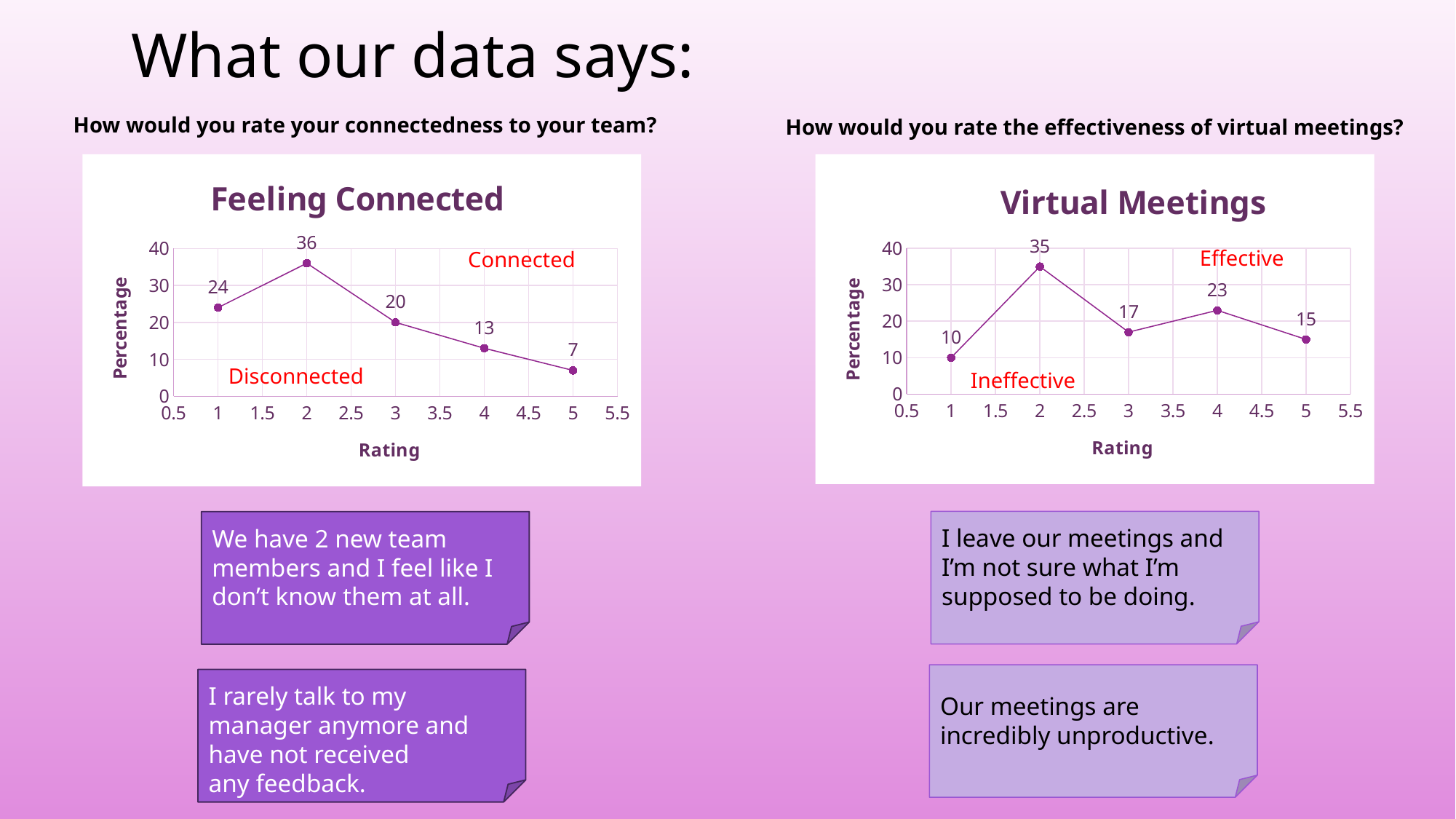
In the Virtual Meetings chart, what is the percentage for rating 4? 23 In the Feeling Connected chart, which rating has the lowest percentage? 5 In the Virtual Meetings chart, which is larger, the percentage for rating 3 or rating 5? Rating 3 In the Virtual Meetings chart, what is the difference between the percentages for rating 2 and rating 4? 12 How many data points are plotted in the Feeling Connected chart? 5 In the Virtual Meetings chart, what is the percentage for rating 1? 10 In the Feeling Connected chart, what is the percentage for rating 5? 7 In the Feeling Connected chart, what is the percentage for rating 2? 36 What type of chart is the Virtual Meetings chart? Line chart In the Virtual Meetings chart, which rating has the highest percentage? 2 In the Feeling Connected chart, which rating has the highest percentage? 2 In the Feeling Connected chart, what is the difference between the percentages for rating 1 and rating 3? 4